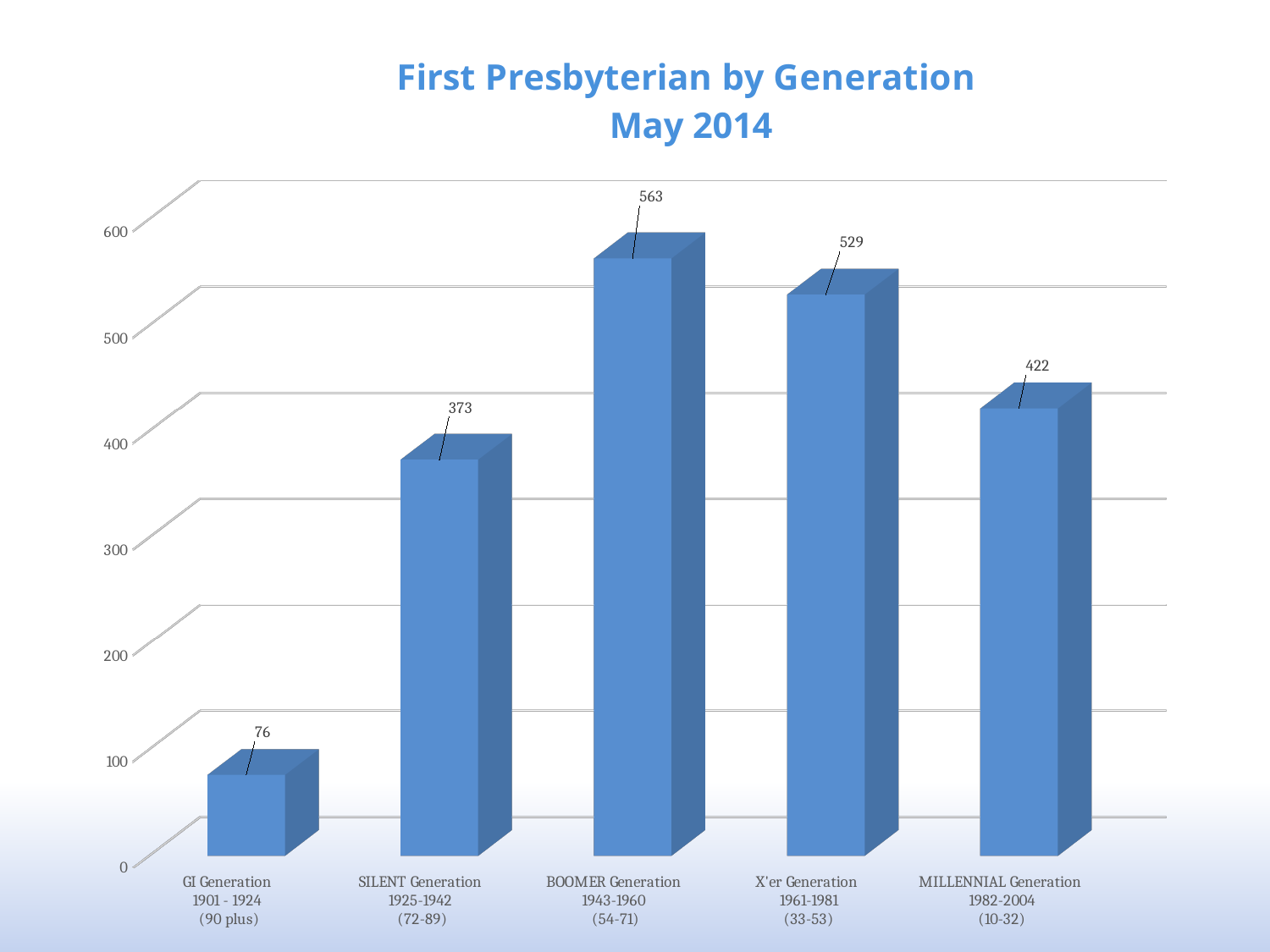
What is the difference between the BOOMER Generation and the X'er Generation values? 34 What is the value for the BOOMER Generation? 563 What is the value for the GI Generation? 76 Which is larger, the value for the SILENT Generation or the MILLENNIAL Generation? MILLENNIAL Generation Which generation has the lowest value? GI Generation What is the difference between the SILENT Generation and the GI Generation values? 297 How many generations are shown on the chart? 5 What is the value for the MILLENNIAL Generation? 422 Is the value for the X'er Generation greater or less than 500? greater Which generation has the highest value? BOOMER Generation What kind of chart is shown on the slide? Bar chart What is the title of the chart? First Presbyterian by Generation May 2014